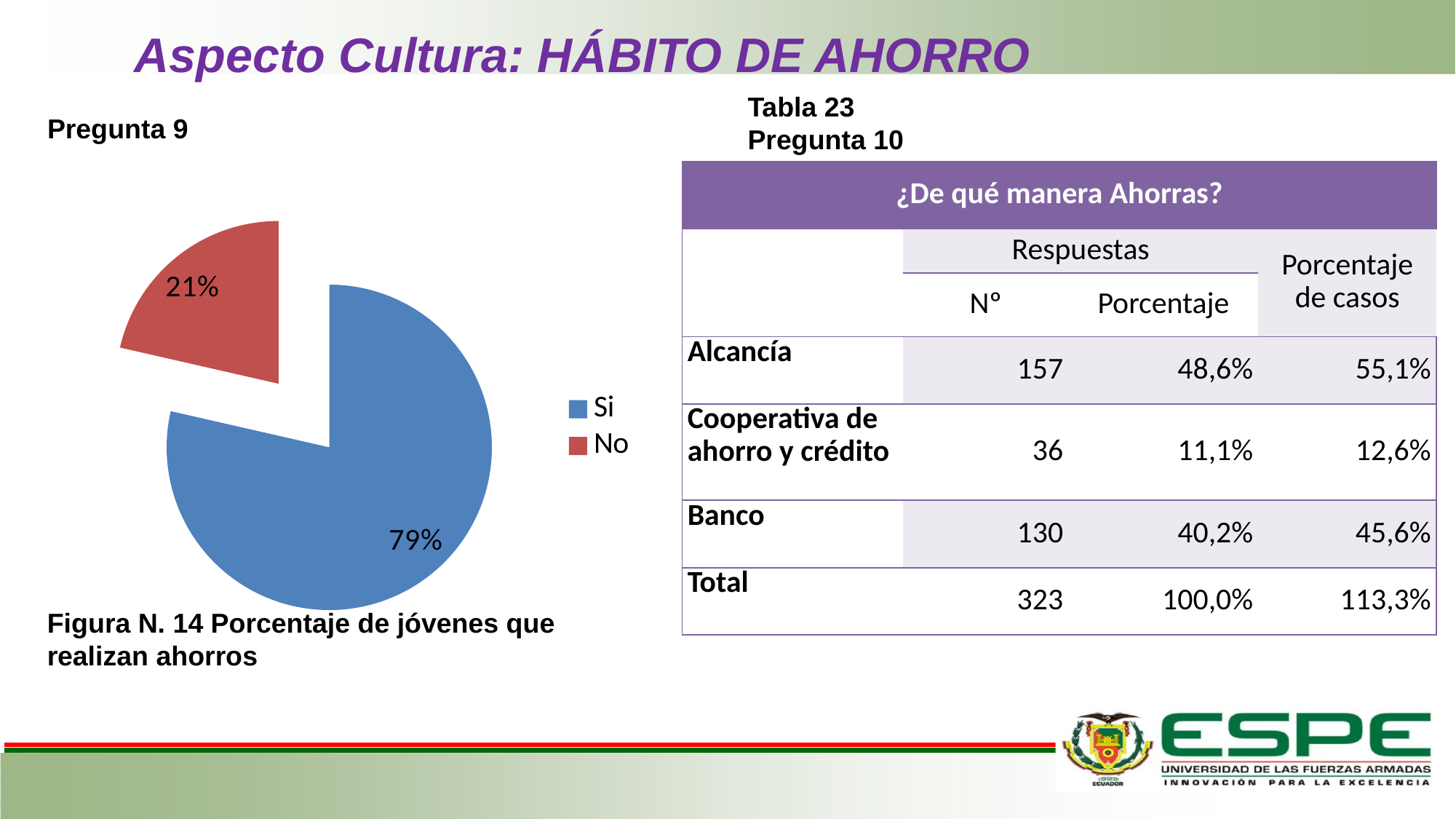
How many entries does the legend of the pie chart list? 2 In the pie chart, is the share for 'Si' greater or less than 50%? greater In the pie chart, what is the difference in percentage points between the 'Si' and 'No' slices? 58 In the pie chart, which slice is the smallest? No In the pie chart, what percentage is shown for the 'No' slice? 21% What kind of chart is shown on the left of the slide? pie chart In the pie chart, what colour is the 'No' slice? red How many slices does the pie chart have? 2 In the pie chart, which slice is larger, 'Si' or 'No'? Si What is the figure caption below the pie chart? Figura N. 14 Porcentaje de jóvenes que realizan ahorros In the pie chart, what percentage is shown for the 'Si' slice? 79% In the pie chart, which slice is the largest? Si